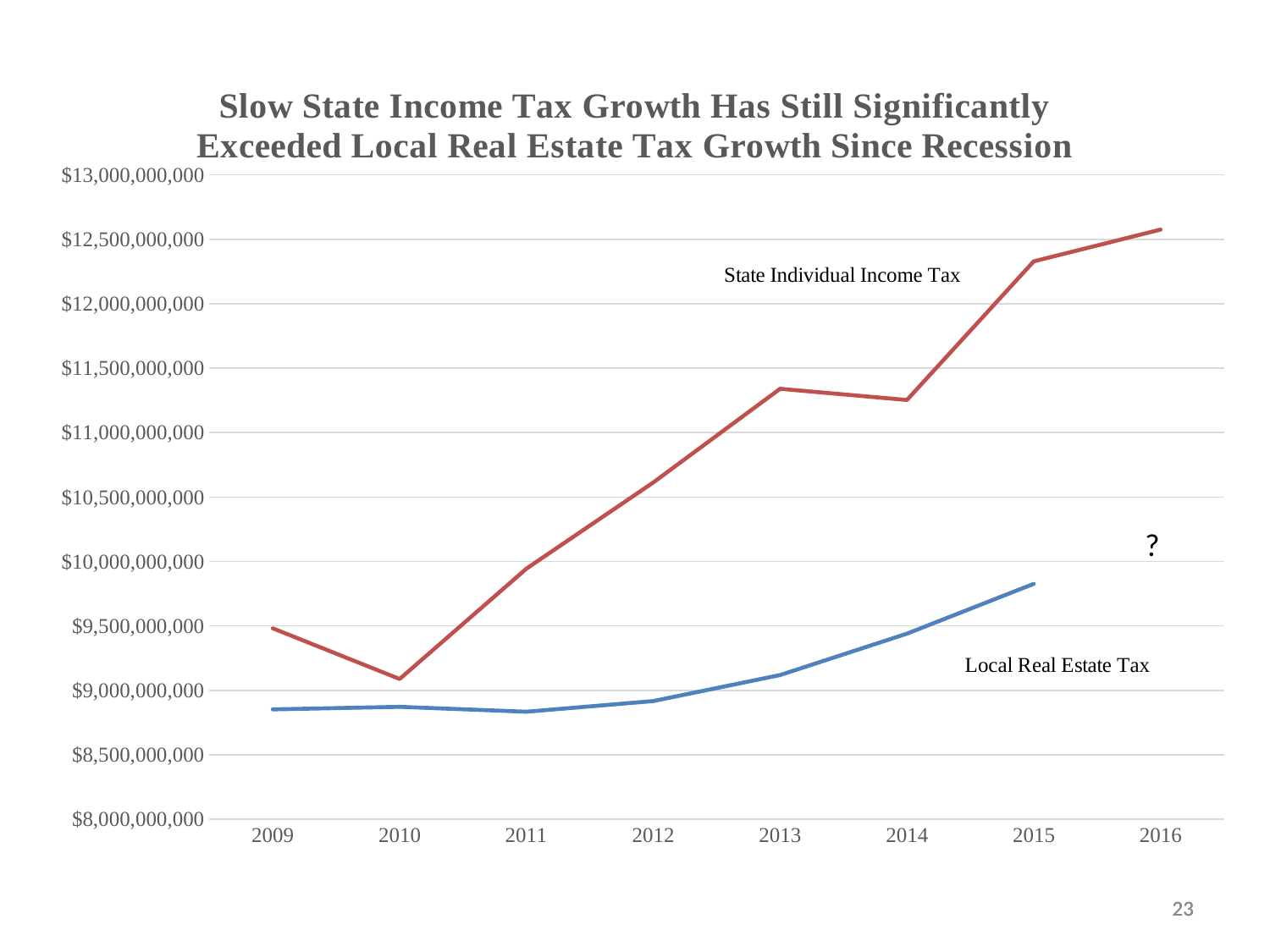
Does Local Real Estate Tax rise or fall from 2012 to 2015? rise In which year is State Individual Income Tax lowest? 2010 Is the value for State Individual Income Tax in 2010 greater or less than $9,500,000,000? less How many data series are plotted on the chart? 2 Is the value for State Individual Income Tax in 2013 greater or less than $11,000,000,000? greater In which year is Local Real Estate Tax highest? 2015 In 2013, which series has the higher value, State Individual Income Tax or Local Real Estate Tax? State Individual Income Tax Is the value for State Individual Income Tax in 2015 greater or less than $12,000,000,000? greater In which year is State Individual Income Tax highest? 2016 What kind of chart is shown on the slide? line chart How many years are shown on the x axis? 8